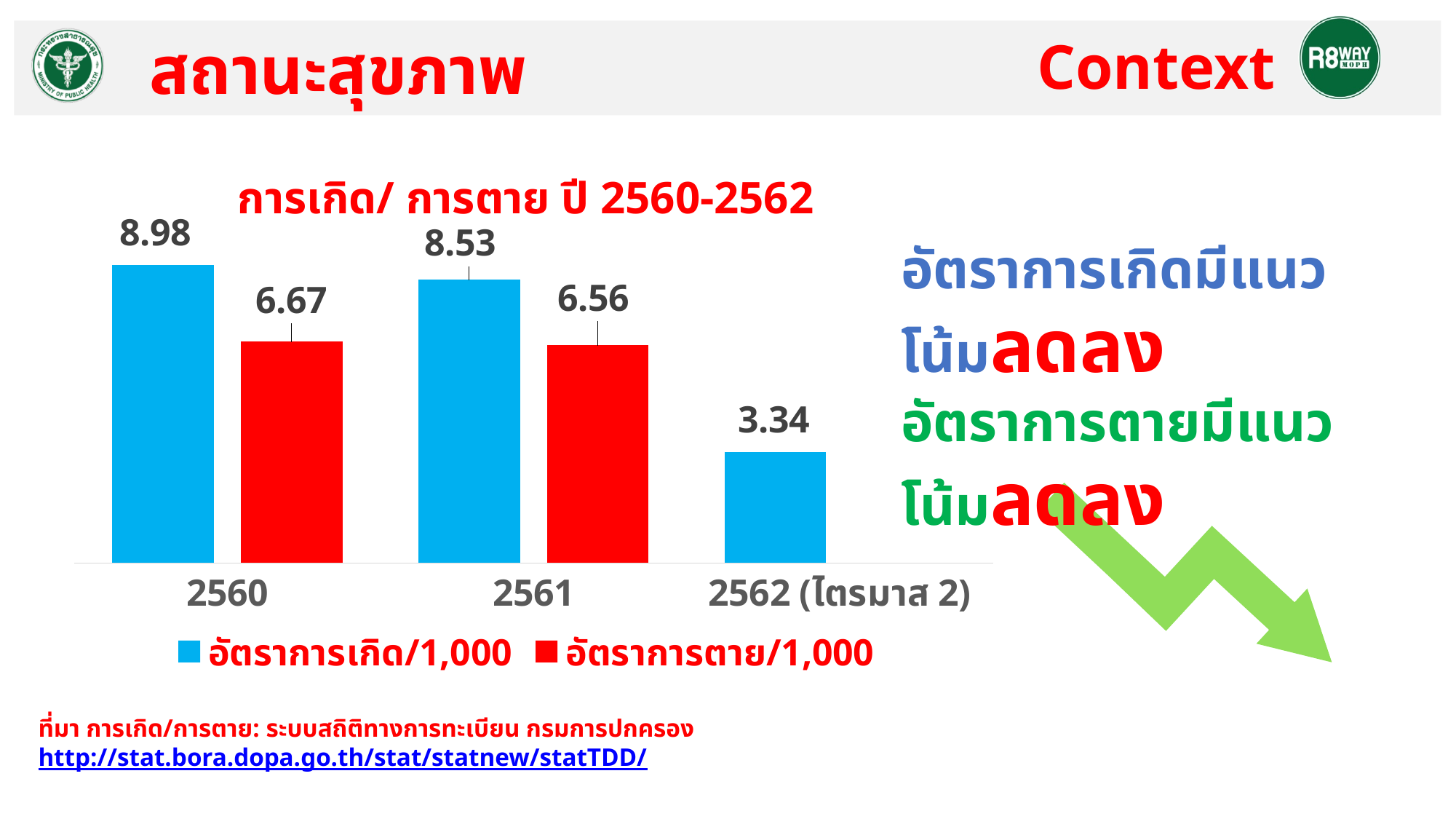
Which year has the highest birth rate (อัตราการเกิด/1,000)? 2560 Does the birth rate (อัตราการเกิด/1,000) rise or fall from 2560 to 2562 (ไตรมาส 2)? fall What is the difference between the birth rate in 2560 and the birth rate in 2561? 0.45 How many series does the legend list? 2 What is the birth rate (อัตราการเกิด/1,000) for 2562 (ไตรมาส 2)? 3.34 What is the difference between the birth rate and the death rate in 2560? 2.31 Which is larger in 2561, the birth rate or the death rate? the birth rate What is the death rate (อัตราการตาย/1,000) for 2560? 6.67 What type of chart is shown on the slide? bar chart What is the death rate (อัตราการตาย/1,000) for 2561? 6.56 What is the birth rate (อัตราการเกิด/1,000) for 2560? 8.98 Which year has the lowest birth rate (อัตราการเกิด/1,000)? 2562 (ไตรมาส 2)